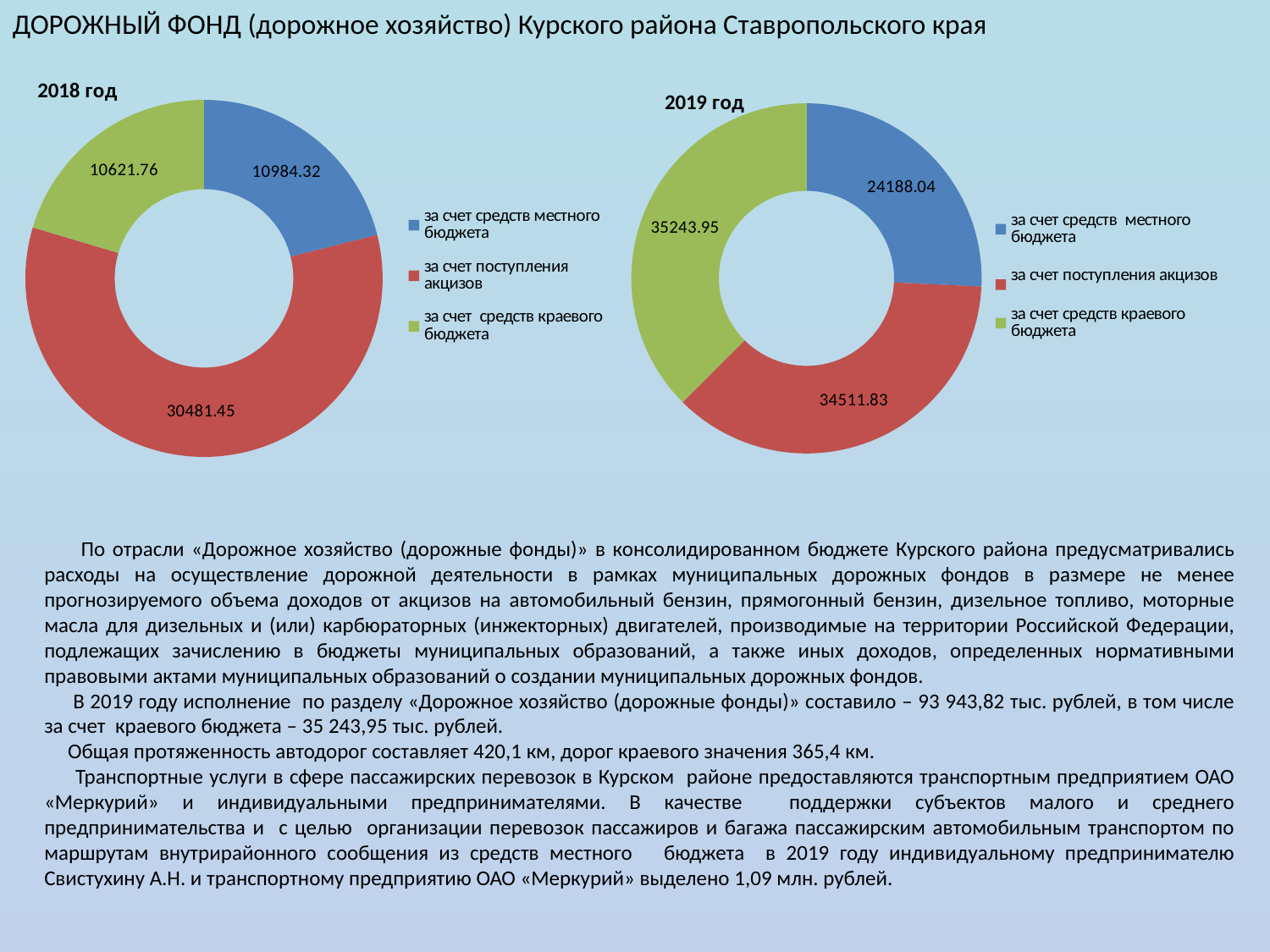
How many slices does the 2018 год chart have? 3 In the 2019 год chart, what is the value for за счет средств краевого бюджета? 35243.95 What is the total of all three values in the 2019 год chart? 93943.82 In the 2018 год chart, which source has the largest value? за счет поступления акцизов What kind of chart is the 2018 год chart? doughnut chart In the 2019 год chart, what is the value for за счет средств местного бюджета? 24188.04 In the 2019 год chart, what is the difference between за счет поступления акцизов and за счет средств местного бюджета? 10323.79 In the 2018 год chart, what is the value for за счет поступления акцизов? 30481.45 In the 2018 год chart, what is the difference between за счет средств местного бюджета and за счет средств краевого бюджета? 362.56 In the 2019 год chart, which source has the smallest value? за счет средств местного бюджета In the 2019 год chart, which is larger: за счет средств краевого бюджета or за счет поступления акцизов? за счет средств краевого бюджета How many entries does the legend of the 2019 год chart list? 3